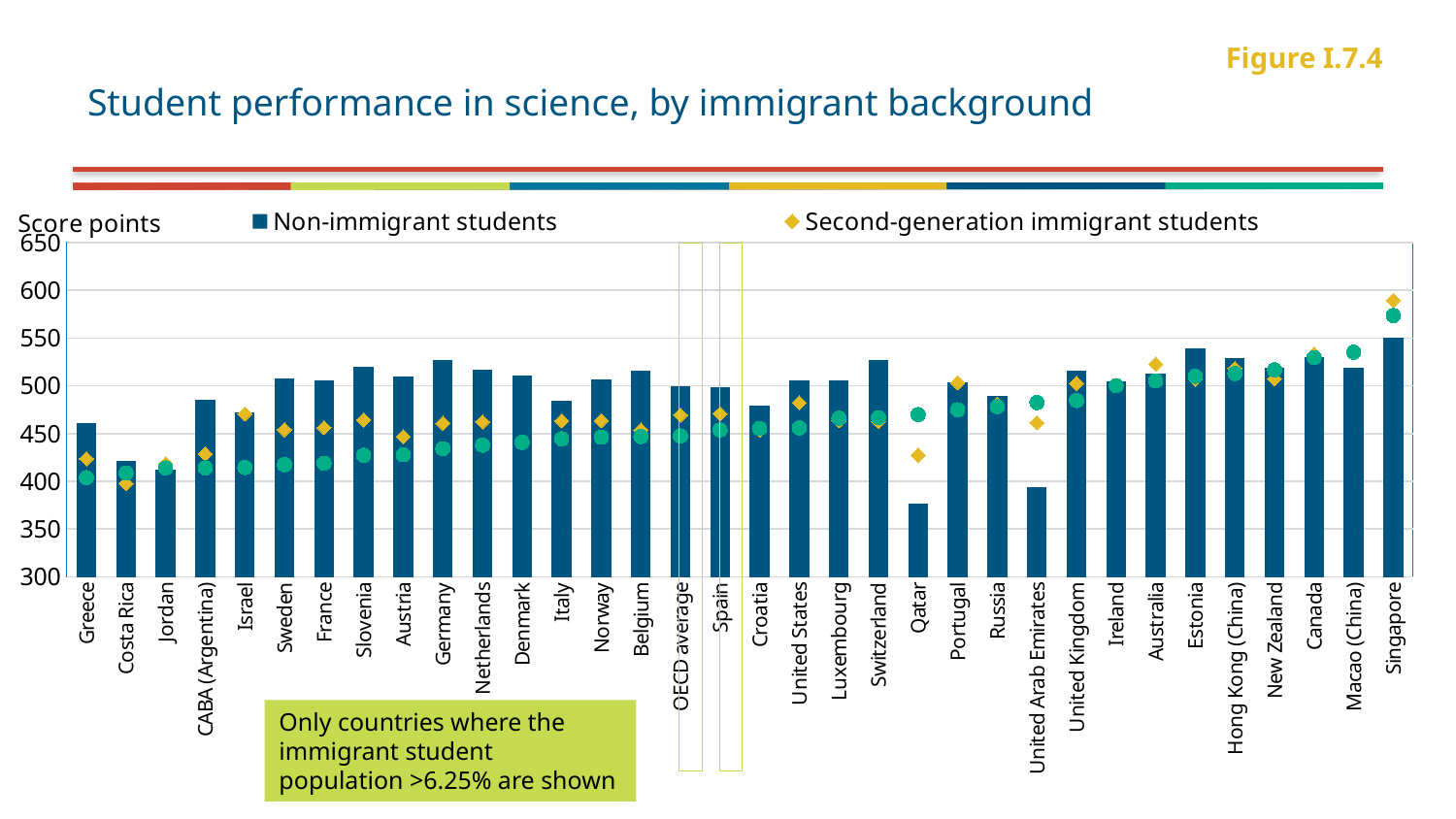
Is the non-immigrant students value for Singapore greater or less than 500? greater Is the second-generation immigrant students value for Singapore greater or less than 550? greater How many series does the legend list? 2 What is the label of the vertical axis? Score points What kind of chart is shown on the slide? bar chart Which country has the highest bar for non-immigrant students? Singapore Is the non-immigrant students value for Qatar greater or less than 400? less Which country has the lowest bar for non-immigrant students? Qatar How many countries/categories are shown on the x axis? 34 Which has the larger non-immigrant students value, Portugal or Qatar? Portugal